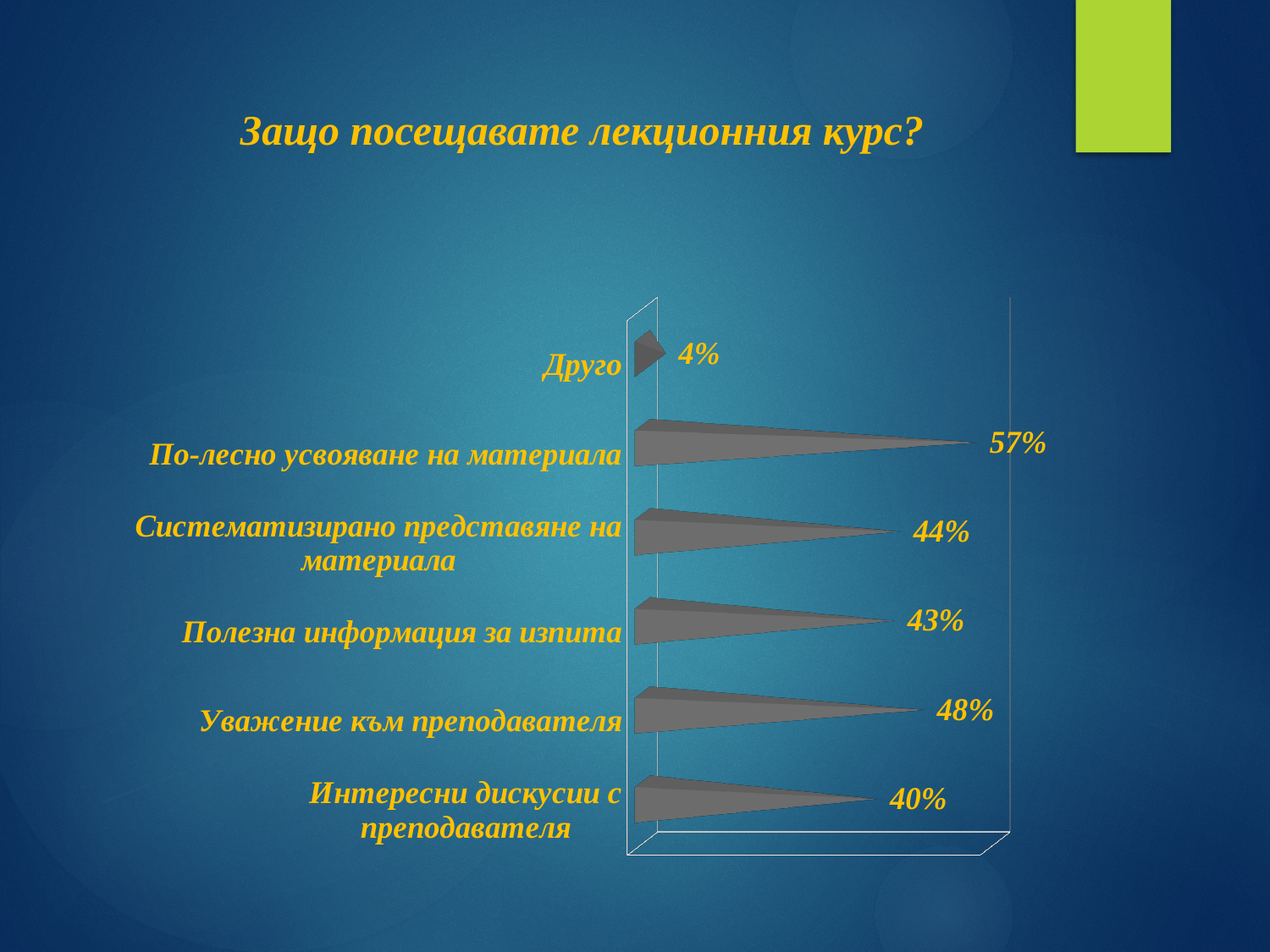
What is the value for "Друго"? 4% Which category has the highest value? По-лесно усвояване на материала Which is larger: the value for "Уважение към преподавателя" or the value for "Полезна информация за изпита"? Уважение към преподавателя What is the difference between the values for "По-лесно усвояване на материала" and "Интересни дискусии с преподавателя"? 17% What kind of chart is shown on the slide? Bar chart How many categories are shown in the chart? 6 Which category has the lowest value? Друго What is the value for "Интересни дискусии с преподавателя"? 40% What is the title of the slide? Защо посещавате лекционния курс? What is the value for "По-лесно усвояване на материала"? 57% What is the value for "Уважение към преподавателя"? 48% What is the difference between the values for "Систематизирано представяне на материала" and "Полезна информация за изпита"? 1%